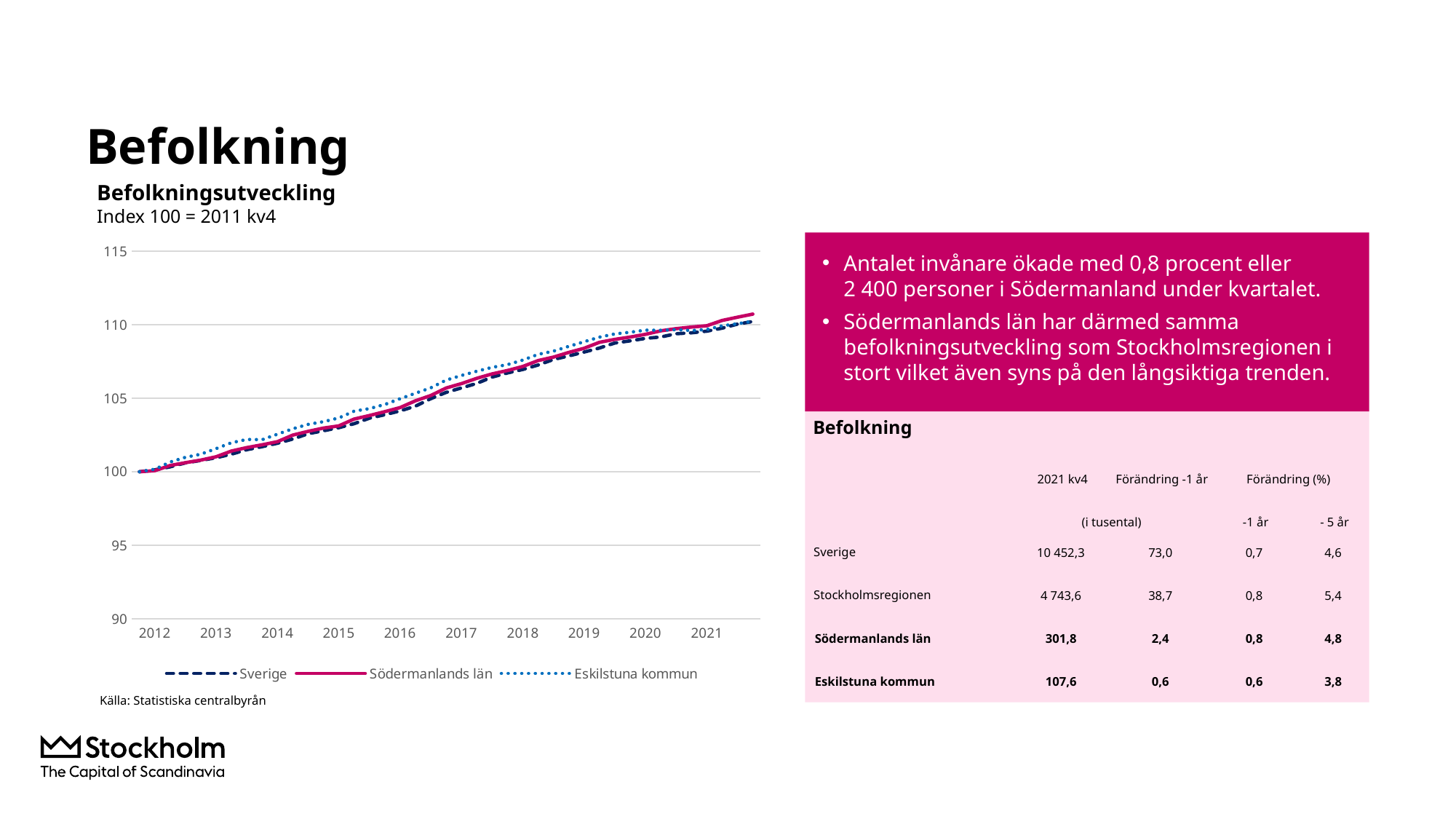
Which series are listed in the chart legend? Sverige, Södermanlands län, Eskilstuna kommun Is the value for Sverige in 2014 greater or less than 105? less What index value do all three series start at in the chart? 100 What kind of chart is shown on the slide? line chart Is the value for Södermanlands län in 2020 greater or less than 105? greater How many year labels are shown on the x axis of the chart? 10 Is the value for Eskilstuna kommun in 2018 greater or less than 105? greater Which series has the highest value in 2017? Eskilstuna kommun How many series does the chart legend list? 3 What is the title of the chart? Befolkningsutveckling Do the values in the chart rise or fall from 2012 to 2021? rise In 2015, which is higher in the chart: Eskilstuna kommun or Sverige? Eskilstuna kommun